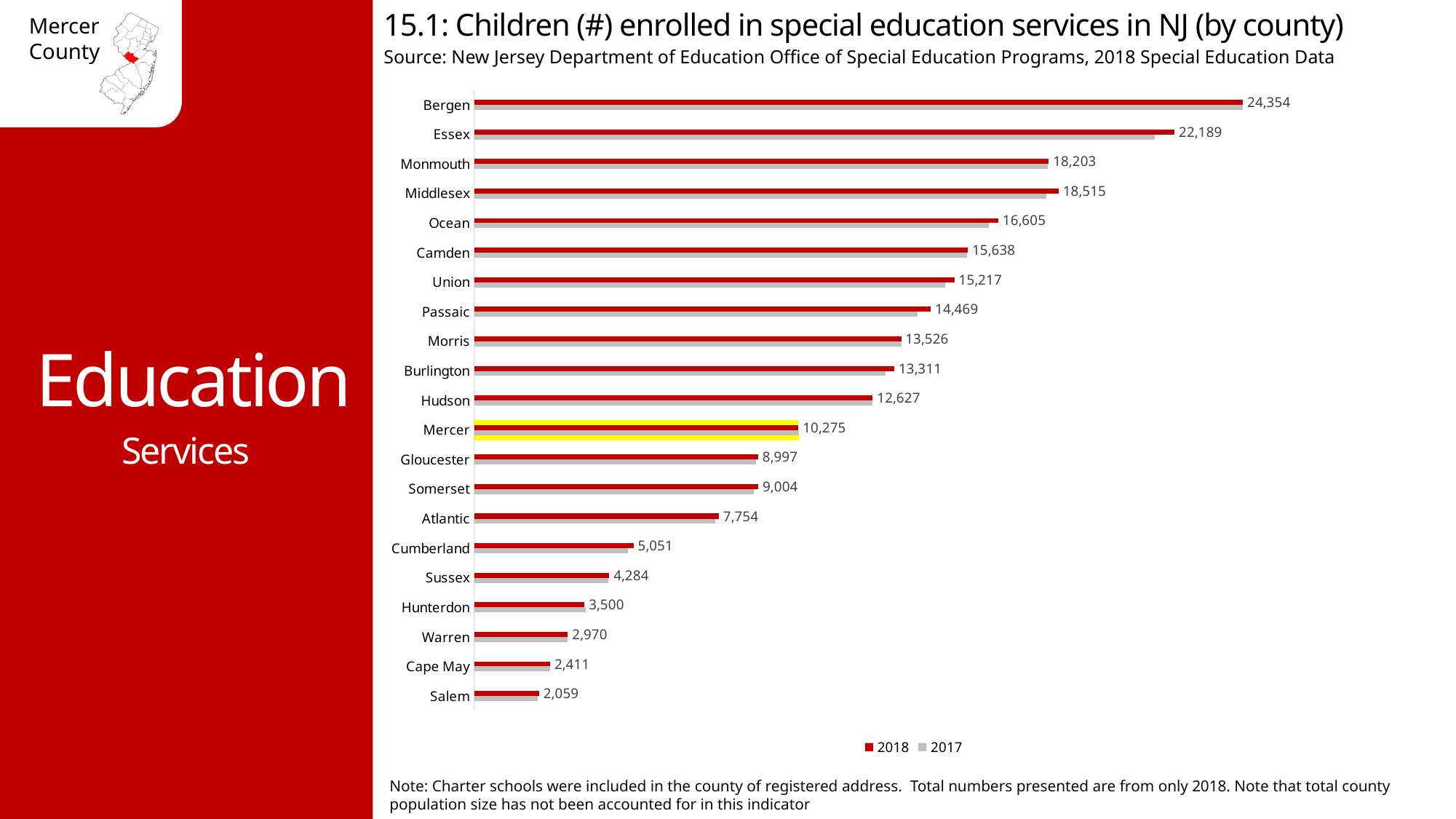
Which county's bars are highlighted in yellow? Mercer Which county has the highest 2018 value? Bergen Which has the larger 2018 value, Hudson or Mercer? Hudson What is the difference between the 2018 values for Bergen and Essex? 2,165 What is the 2018 value for Ocean? 16,605 What kind of chart is shown? Bar chart How many series does the legend list? 2 How many counties are shown on the chart? 21 What is the 2018 value for Mercer? 10,275 Which county has the lowest 2018 value? Salem What is the difference between the 2018 values for Middlesex and Monmouth? 312 What is the 2018 value for Bergen? 24,354